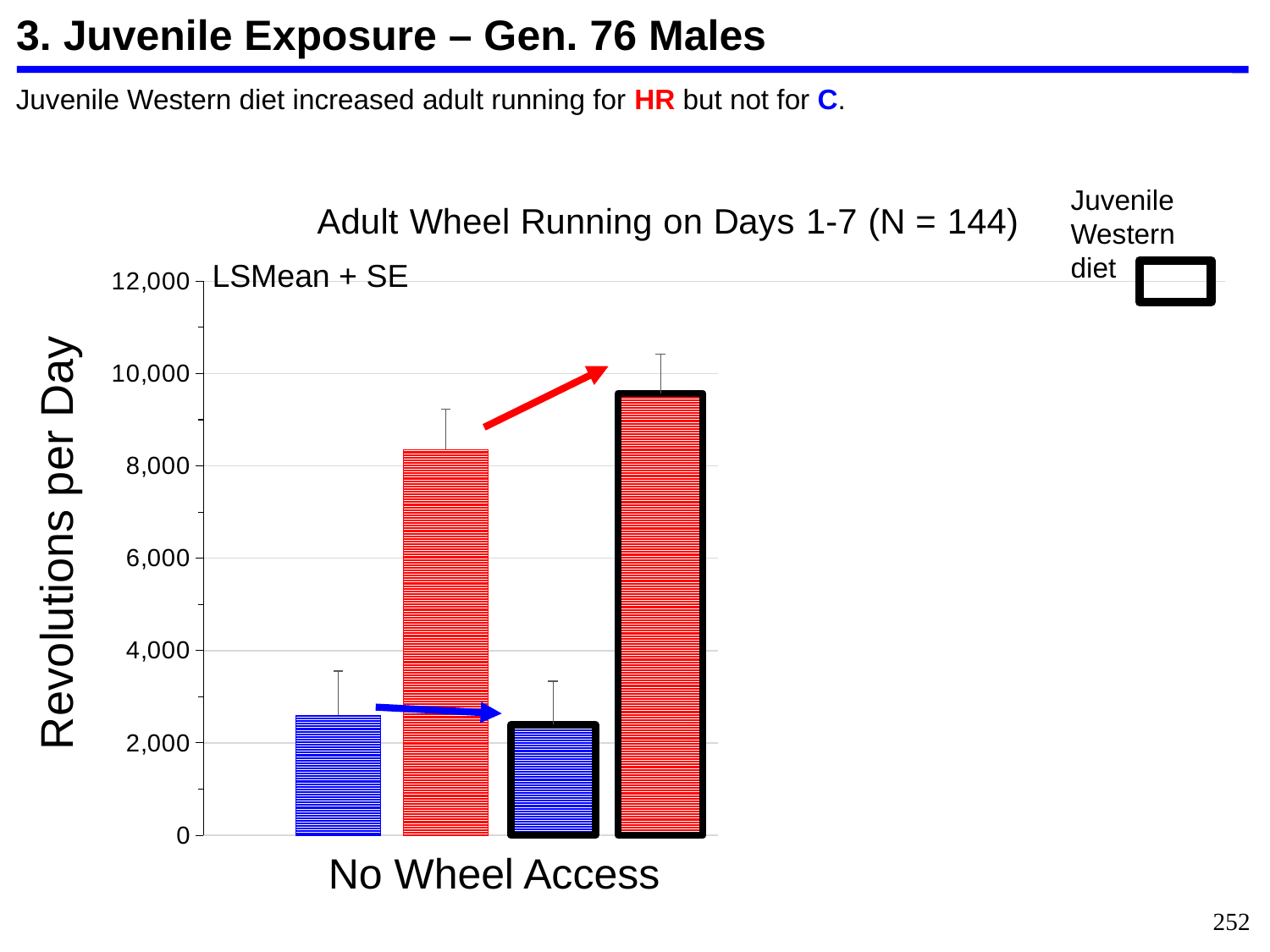
What is the category label shown on the x axis? No Wheel Access Is the value of the rightmost (black-outlined red) bar greater or less than 10,000? less Is the value of the second bar from the left (red, no outline) greater or less than 6,000? greater What is the label on the y axis of the chart? Revolutions per Day Which bar is the tallest in the chart? the rightmost red bar with the black outline (HR, juvenile Western diet) Which is larger: the black-outlined red bar or the red bar without an outline? the black-outlined red bar What is the highest tick value shown on the y axis? 12,000 What is the title of the chart? Adult Wheel Running on Days 1-7 (N = 144) What kind of chart is shown on the slide? bar chart Is the value of the leftmost blue bar greater or less than 4,000? less How many bars are plotted in the chart? 4